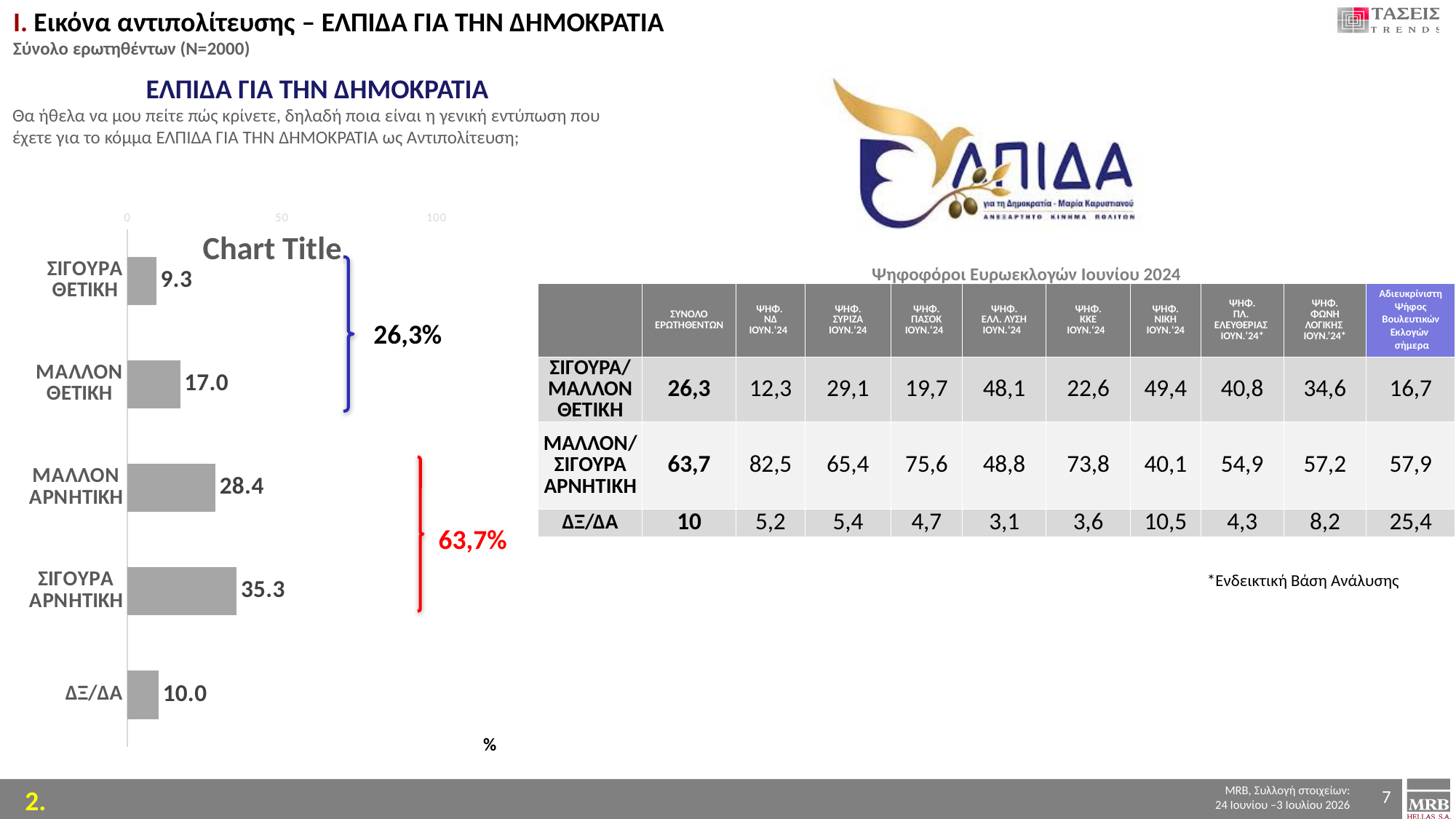
What is the value for ΜΑΛΛΟΝ ΑΡΝΗΤΙΚΗ in the bar chart? 28.4 What is the difference between the values for ΣΙΓΟΥΡΑ ΑΡΝΗΤΙΚΗ and ΜΑΛΛΟΝ ΑΡΝΗΤΙΚΗ in the bar chart? 6.9 Which is larger in the bar chart, the value for ΜΑΛΛΟΝ ΘΕΤΙΚΗ or the value for ΔΞ/ΔΑ? ΜΑΛΛΟΝ ΘΕΤΙΚΗ What is the value for ΔΞ/ΔΑ in the bar chart? 10.0 What is the title printed on the chart? Chart Title Which category has the lowest value in the bar chart? ΣΙΓΟΥΡΑ ΘΕΤΙΚΗ How many categories are shown in the bar chart? 5 What kind of chart is shown on the slide? bar chart Which category has the highest value in the bar chart? ΣΙΓΟΥΡΑ ΑΡΝΗΤΙΚΗ Is the value for ΣΙΓΟΥΡΑ ΑΡΝΗΤΙΚΗ in the bar chart greater or less than 50? less What is the value for ΜΑΛΛΟΝ ΘΕΤΙΚΗ in the bar chart? 17.0 What is the value for ΣΙΓΟΥΡΑ ΘΕΤΙΚΗ in the bar chart? 9.3